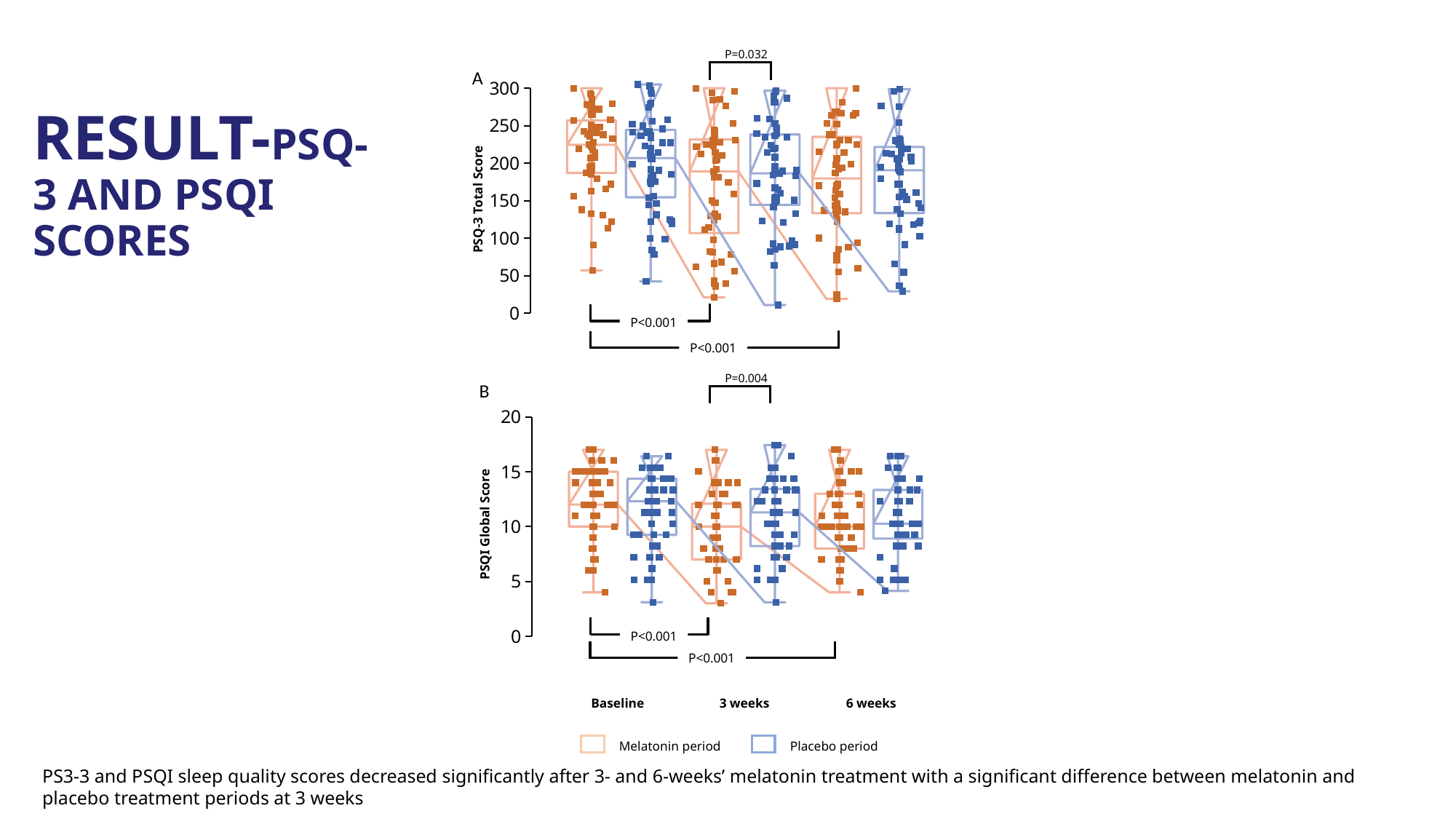
What kind of chart is chart A (PSQ-3 Total Score)? Box plot In chart A, what P value is printed for the change from Baseline to 6 weeks? P<0.001 In chart A, is the median PSQ-3 Total Score for the melatonin period at Baseline greater or less than 200? greater In chart A, is the median PSQ-3 Total Score for the melatonin period at 6 weeks greater or less than 250? less Which series is shown in blue in the legend? Placebo period In chart A, does the median PSQ-3 Total Score for the melatonin period rise or fall from Baseline to 6 weeks? Fall In chart B, does the median PSQI Global Score for the melatonin period rise or fall from Baseline to 3 weeks? Fall How many time points are shown on the x axis of chart B (PSQI Global Score)? 3 How many series does the legend list for the charts? 2 In chart B, what P value is printed for the comparison between the melatonin and placebo periods at 3 weeks? P=0.004 What is the y-axis label of chart B? PSQI Global Score In chart A, what P value is printed for the comparison between the melatonin and placebo periods at 3 weeks? P=0.032